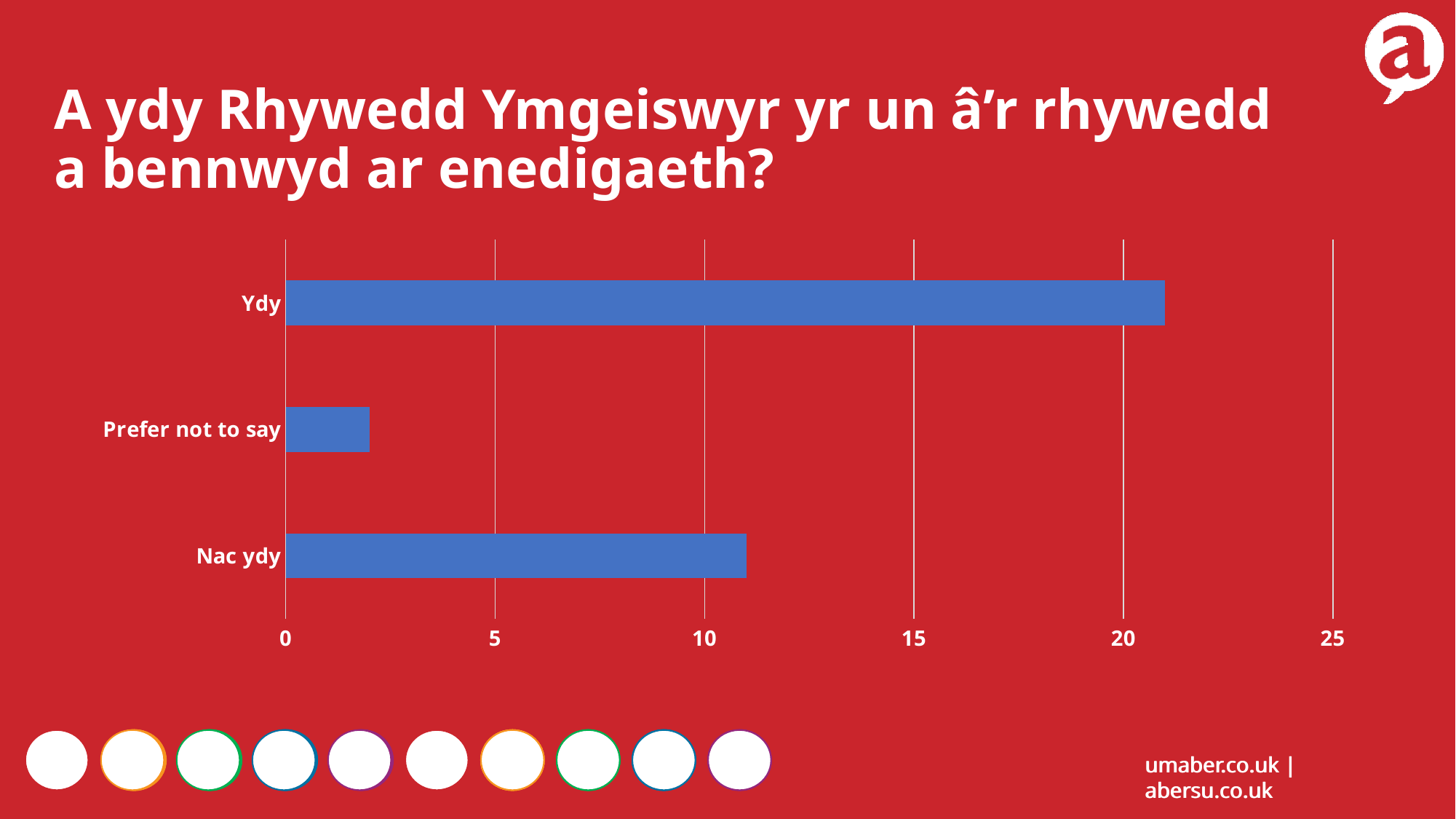
Which category has the lowest value? Prefer not to say Is the value for Ydy greater or less than 20? greater How many categories are shown in the chart? 3 Which is larger, the value for Ydy or the value for Nac ydy? Ydy Which category has the highest value? Ydy What is the highest value shown on the horizontal axis? 25 Is the value for Prefer not to say greater or less than 5? less Which is larger, the value for Nac ydy or the value for Prefer not to say? Nac ydy What colour are the bars in the chart? blue Is the value for Nac ydy greater or less than 15? less What kind of chart is shown on the slide? bar chart